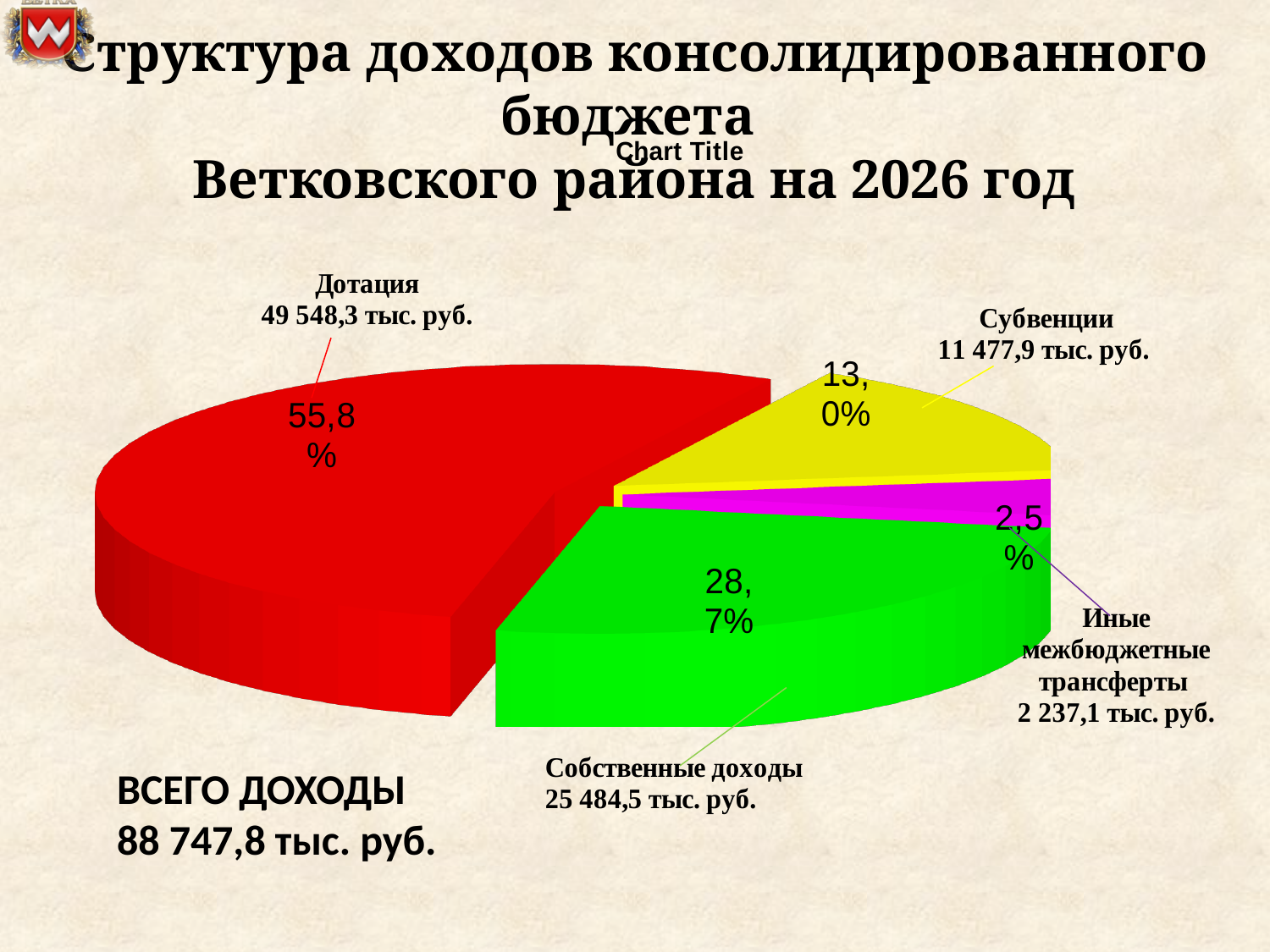
Which is larger, the slice for Собственные доходы or the slice for Субвенции? Собственные доходы What share of the pie does Собственные доходы represent? 28,7% What share of the pie does Субвенции represent? 13,0% What is the value shown for Дотация? 49 548,3 тыс. руб. What is the value shown for Субвенции? 11 477,9 тыс. руб. What share of the pie does Дотация represent? 55,8% Which category has the smallest slice of the pie? Иные межбюджетные трансферты Which category has the largest slice of the pie? Дотация What kind of chart is shown on the slide? Pie chart How many slices does the pie chart have? 4 What is the value shown for Иные межбюджетные трансферты? 2 237,1 тыс. руб.